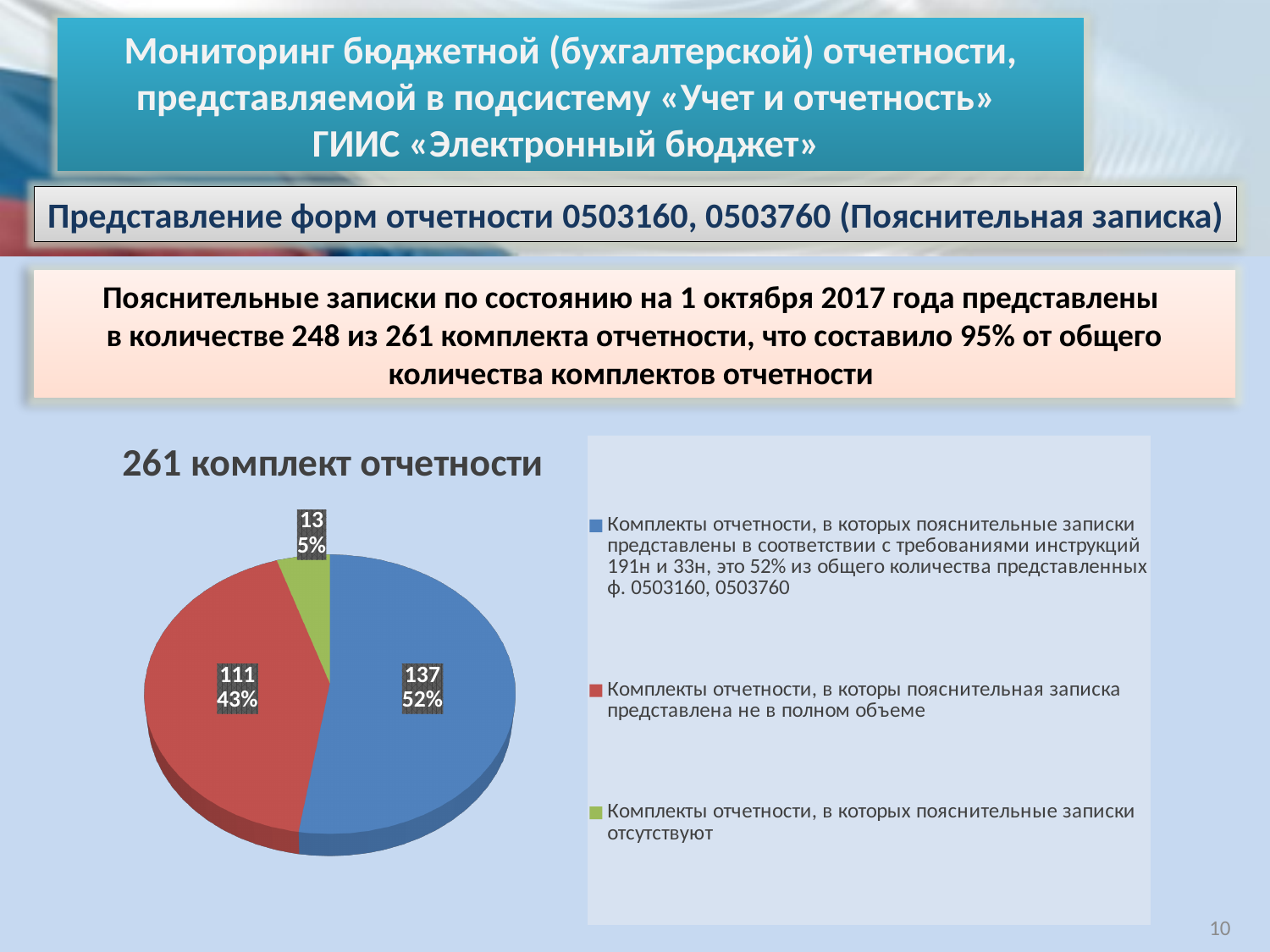
How many entries does the legend list? 3 How many slices does the pie chart have? 3 What share of the pie is taken by report sets where explanatory notes are absent? 5% How many report sets have no explanatory notes at all? 13 What is the title of the chart? 261 комплект отчетности How many report sets have explanatory notes submitted in accordance with the requirements of instructions 191н and 33н? 137 Which category has the smallest slice? Комплекты отчетности, в которых пояснительные записки отсутствуют What is the difference between the number of report sets with notes submitted in accordance with requirements and those submitted not in full? 26 How many report sets have an explanatory note submitted not in full? 111 What kind of chart is shown on the slide? Pie chart Which category has the largest slice? Комплекты отчетности, в которых пояснительные записки представлены в соответствии с требованиями инструкций 191н и 33н What share of the pie is taken by report sets where the explanatory note was submitted not in full? 43%